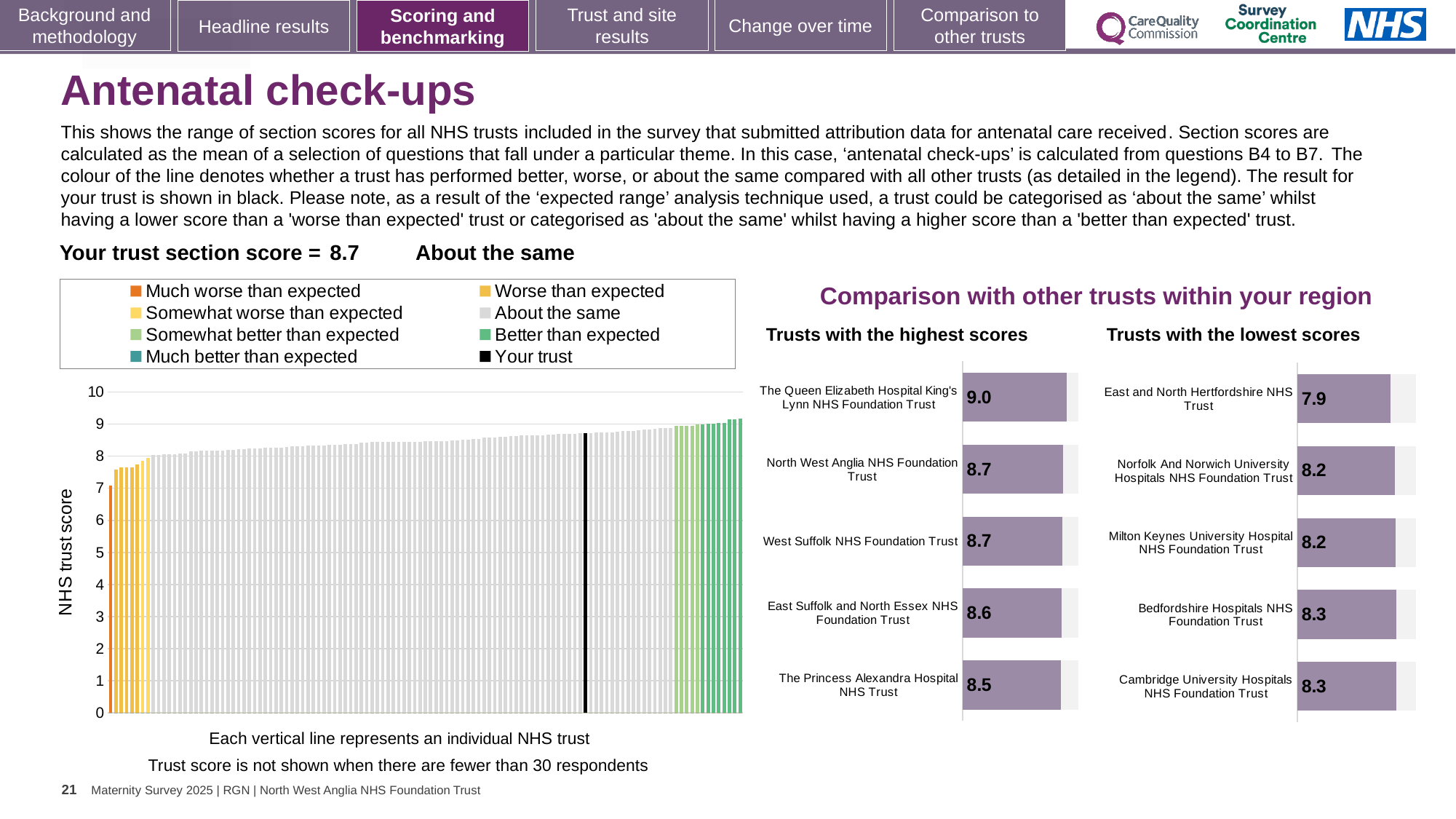
In the 'Trusts with the highest scores' chart, which trust has the highest score? The Queen Elizabeth Hospital King's Lynn NHS Foundation Trust What kind of chart is the main 'NHS trust score' chart on the left of the slide? Bar chart How many trusts are listed in the 'Trusts with the highest scores' chart? 5 In the 'Trusts with the highest scores' chart, what is the score for The Queen Elizabeth Hospital King's Lynn NHS Foundation Trust? 9.0 How many entries does the legend of the main 'NHS trust score' chart list? 8 In the 'Trusts with the highest scores' chart, what is the difference between the scores of The Queen Elizabeth Hospital King's Lynn NHS Foundation Trust and The Princess Alexandra Hospital NHS Trust? 0.5 In the 'Trusts with the lowest scores' chart, what is the score for East and North Hertfordshire NHS Trust? 7.9 In the main 'NHS trust score' chart, is the value of the black bar representing your trust greater or less than 8? greater In the 'Trusts with the lowest scores' chart, which has the higher score: Bedfordshire Hospitals NHS Foundation Trust or Norfolk And Norwich University Hospitals NHS Foundation Trust? Bedfordshire Hospitals NHS Foundation Trust In the main 'NHS trust score' chart, do the values rise or fall from left to right along the x axis? Rise In the 'Trusts with the lowest scores' chart, which trust has the lowest score? East and North Hertfordshire NHS Trust In the 'Trusts with the lowest scores' chart, what is the score for Cambridge University Hospitals NHS Foundation Trust? 8.3